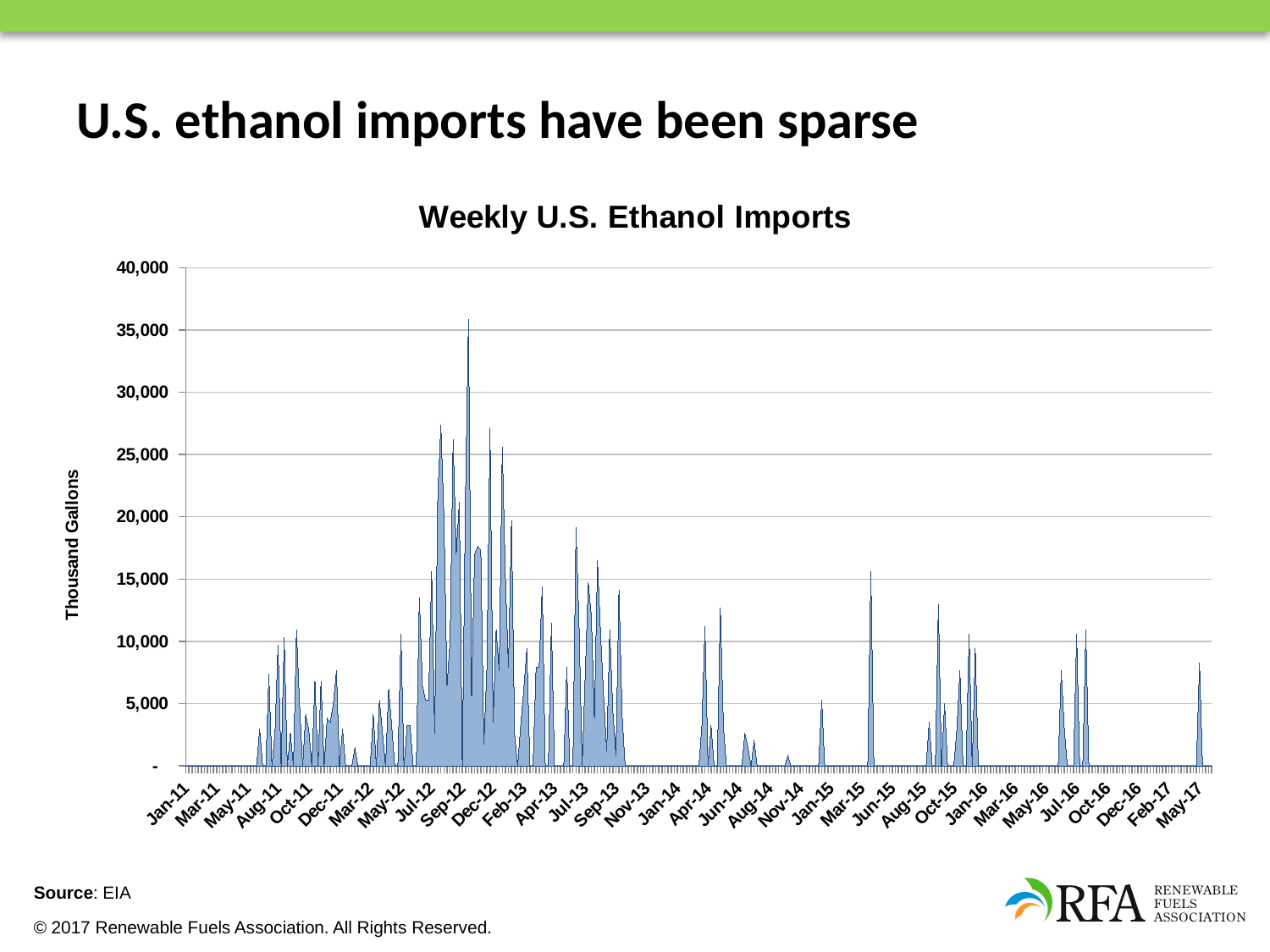
Is the highest peak in the chart, around Sep-12, greater or less than 30,000 thousand gallons? greater What is the title of the chart? Weekly U.S. Ethanol Imports Is the peak around Mar-15 greater or less than 20,000 thousand gallons? less Is the peak around Apr-14 greater or less than 15,000 thousand gallons? less Were weekly ethanol imports generally higher in 2012 or in 2016? 2012 What kind of chart is shown on the slide? Area chart Which period had the larger peak in weekly imports: around Sep-12 or around Jul-16? Sep-12 What is the highest value shown on the vertical axis? 40,000 What is the label on the vertical axis of the chart? Thousand Gallons